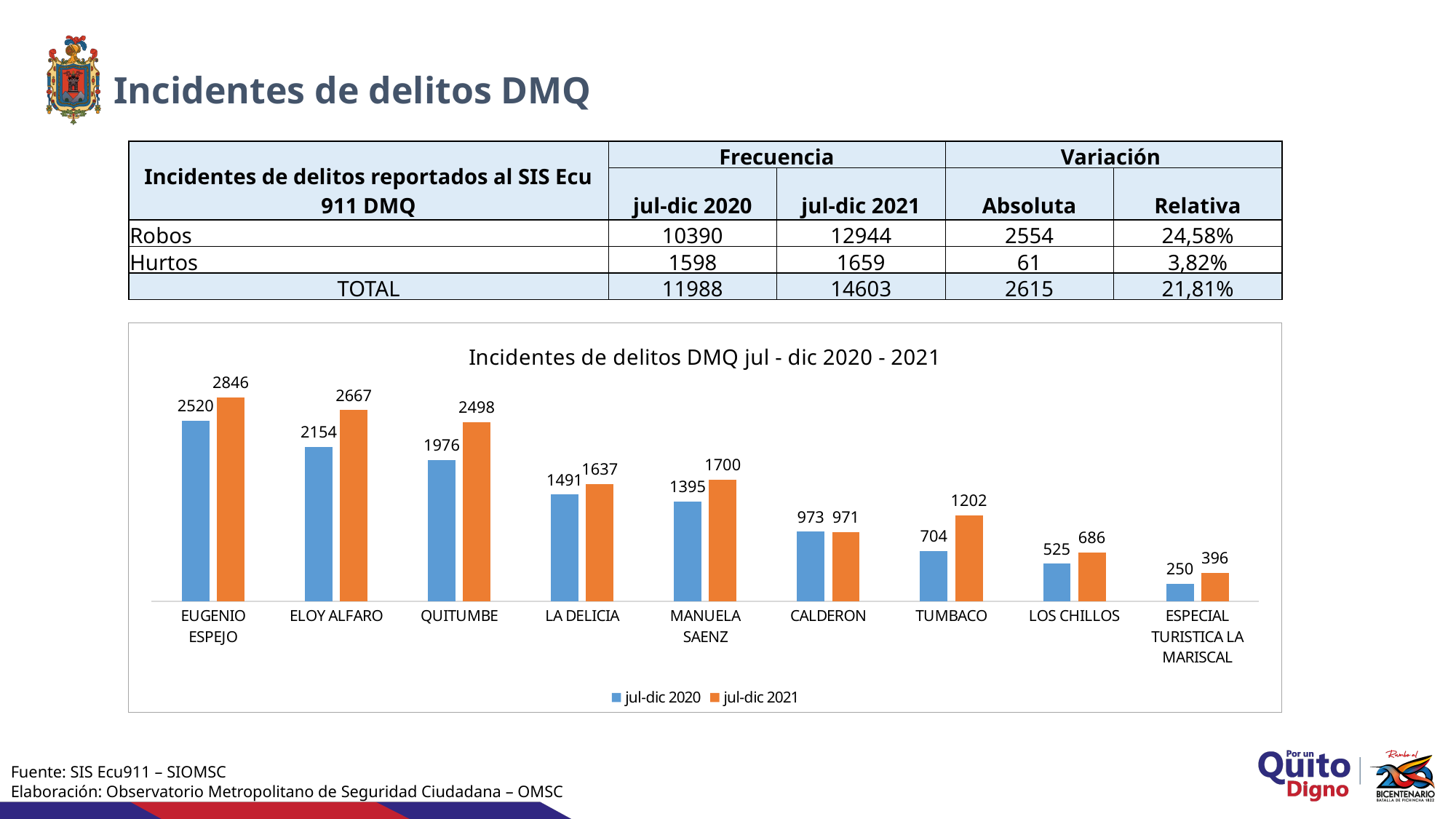
What is the jul-dic 2021 value for EUGENIO ESPEJO? 2846 How many categories are shown on the x axis of the chart? 9 What is the title of the chart? Incidentes de delitos DMQ jul - dic 2020 - 2021 Which is larger for LOS CHILLOS, the jul-dic 2020 value or the jul-dic 2021 value? jul-dic 2021 What kind of chart is shown on the slide? bar chart What is the jul-dic 2020 value for MANUELA SAENZ? 1395 How many series does the chart legend list? 2 What is the difference between the jul-dic 2021 and jul-dic 2020 values for TUMBACO? 498 What is the jul-dic 2020 value for TUMBACO? 704 What is the difference between the jul-dic 2020 values for ELOY ALFARO and QUITUMBE? 178 Which category has the highest jul-dic 2021 value? EUGENIO ESPEJO Which category has the lowest jul-dic 2020 value? ESPECIAL TURISTICA LA MARISCAL